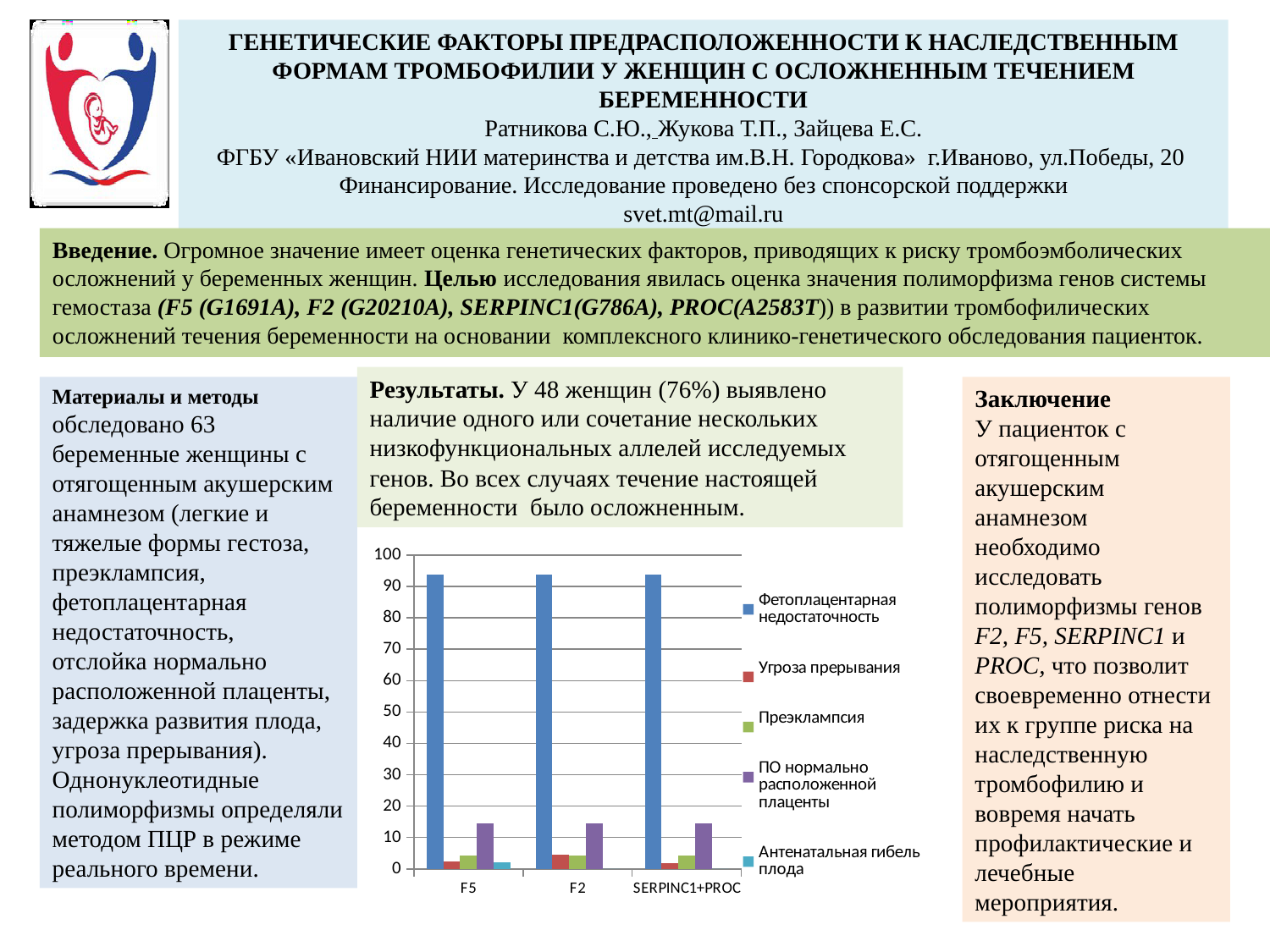
For the F5 category, which is larger: Фетоплацентарная недостаточность or Преэклампсия? Фетоплацентарная недостаточность How many series does the chart legend list? 5 Is the value of Преэклампсия for SERPINC1+PROC greater or less than 10? less What kind of chart is shown on the slide? bar chart What is the last series listed in the chart legend? Антенатальная гибель плода Is the value of Фетоплацентарная недостаточность for F2 greater or less than 90? greater Is the value of ПО нормально расположенной плаценты for F5 greater or less than 20? less How many categories are shown on the x axis of the chart? 3 What is the maximum value shown on the chart's vertical axis? 100 For the F2 category, which is larger: ПО нормально расположенной плаценты or Угроза прерывания? ПО нормально расположенной плаценты Which series has the highest value for the F5 category? Фетоплацентарная недостаточность Which series has the highest value for the SERPINC1+PROC category? Фетоплацентарная недостаточность